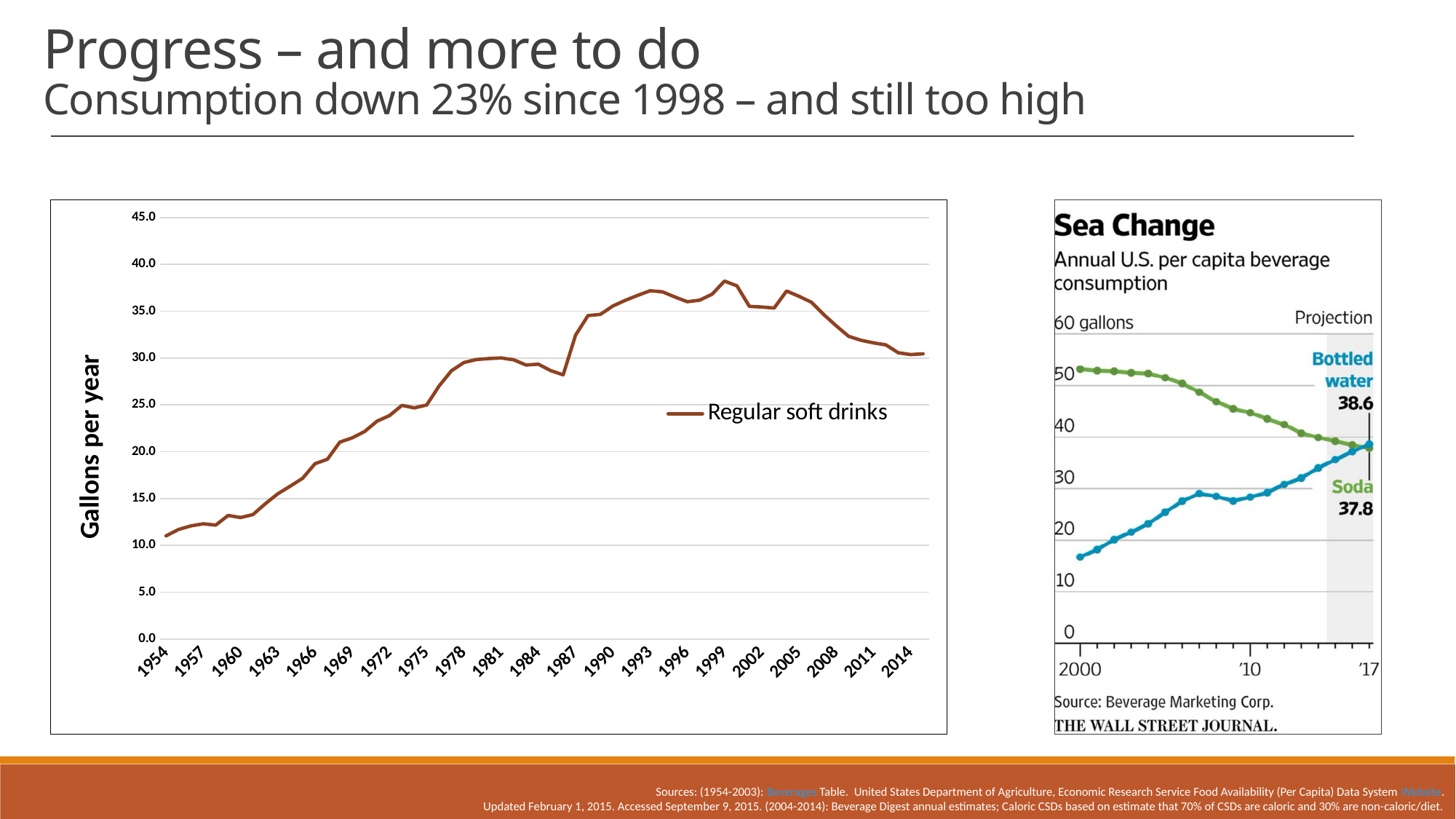
On the left chart, do the values for regular soft drinks rise or fall between 1954 and 1981? rise On the left chart, is the value for 1969 greater or less than 20.0? greater On the Sea Change chart, what is the difference between the projected 2017 values for bottled water and soda? 0.8 On the Sea Change chart, what is the projected 2017 value for bottled water? 38.6 On the left chart, what series does the legend list? Regular soft drinks On the left chart, what is the y-axis label? Gallons per year On the left chart, do the values for regular soft drinks rise or fall between 2005 and 2014? fall What kind of chart is the left chart? line chart On the left chart, is the value for 1999 greater or less than 35.0? greater On the left chart, is the value for 1954 greater or less than 15.0? less On the Sea Change chart, what is the projected 2017 value for soda? 37.8